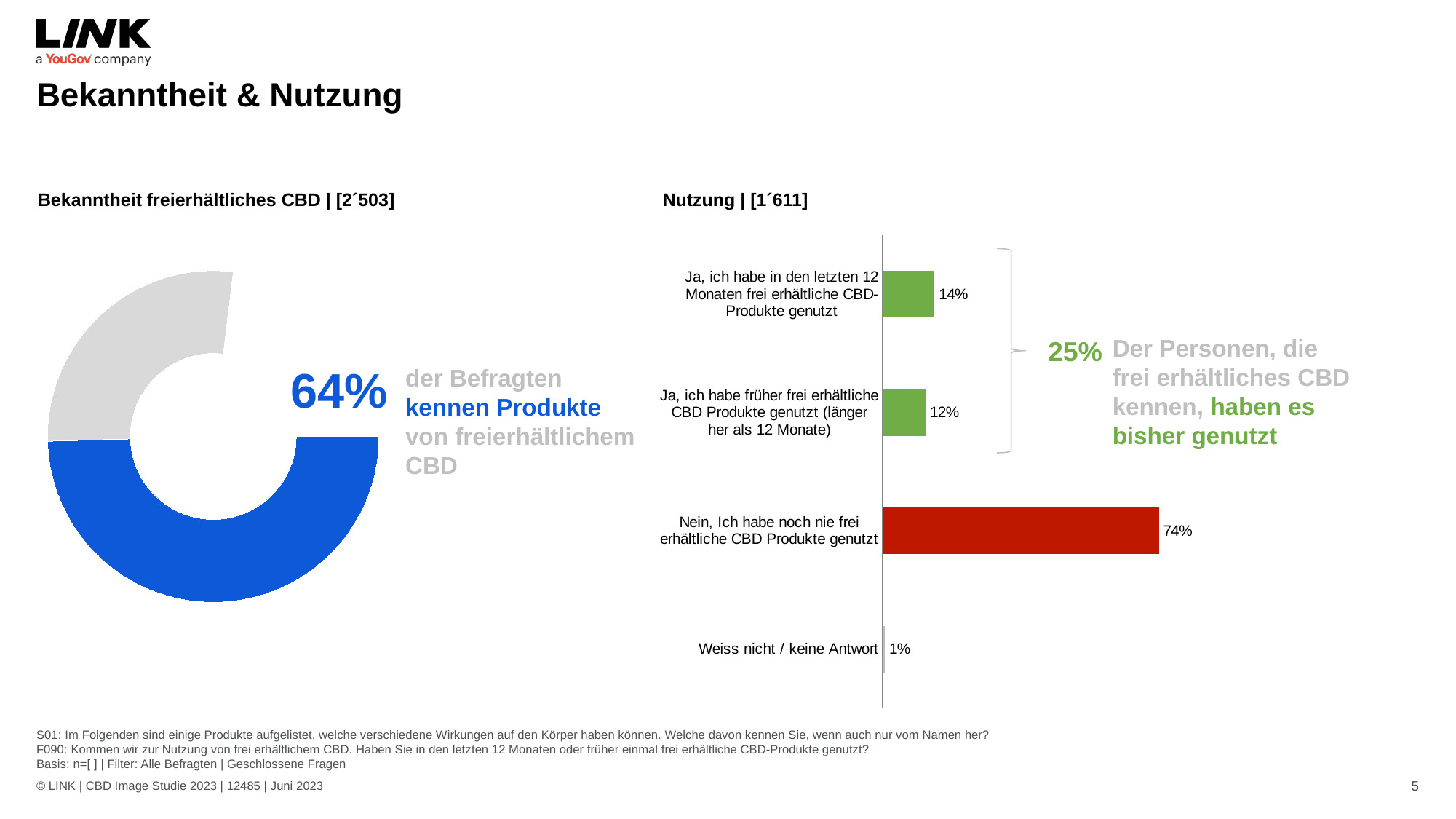
In the 'Nutzung' bar chart, which category has the lowest value? Weiss nicht / keine Antwort In the 'Nutzung' bar chart, what is the value for 'Ja, ich habe früher frei erhältliche CBD Produkte genutzt (länger her als 12 Monate)'? 12% How many categories does the 'Nutzung' bar chart show? 4 In the 'Nutzung' bar chart, what is the value for 'Nein, Ich habe noch nie frei erhältliche CBD Produkte genutzt'? 74% In the 'Nutzung' bar chart, what is the difference between the 'Nein' value and the 'Ja, in den letzten 12 Monaten' value? 60% In the 'Nutzung' bar chart, what is the value for 'Ja, ich habe in den letzten 12 Monaten frei erhältliche CBD-Produkte genutzt'? 14% What kind of chart is the 'Nutzung' chart on the right? Bar chart In the 'Nutzung' bar chart, which is larger: usage in the last 12 months or usage longer than 12 months ago? Usage in the last 12 months (14%) In the 'Bekanntheit freierhältliches CBD' doughnut chart, what share of respondents know freely available CBD products? 64% What kind of chart is the 'Bekanntheit freierhältliches CBD' chart on the left? Doughnut chart In the 'Nutzung' bar chart, what is the value for 'Weiss nicht / keine Antwort'? 1% In the 'Nutzung' bar chart, which category has the highest value? Nein, Ich habe noch nie frei erhältliche CBD Produkte genutzt